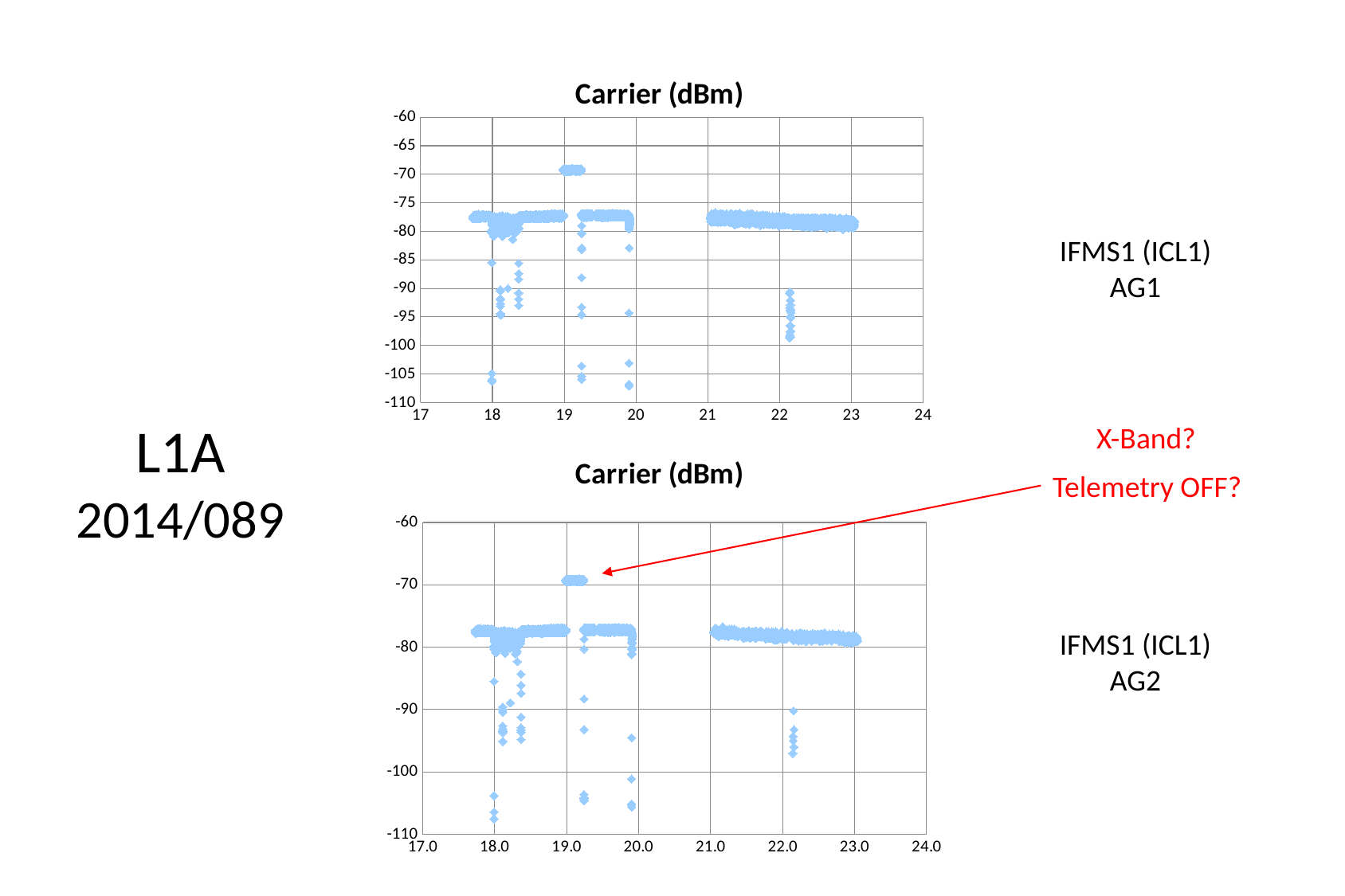
What is the title of the bottom chart on the slide? Carrier (dBm) In the bottom chart (AG2), is the value of the cluster of points just after x = 19.0 greater or less than -75? greater In the top chart (AG1), are the isolated points near x = 22.2 greater or less than -85? less In the top chart (AG1), are the values of the main band of points between x = 21 and x = 23 greater or less than -85? greater What is the lowest value shown on the y axis of the top chart? -110 What kind of chart is the top chart on the slide? scatter chart